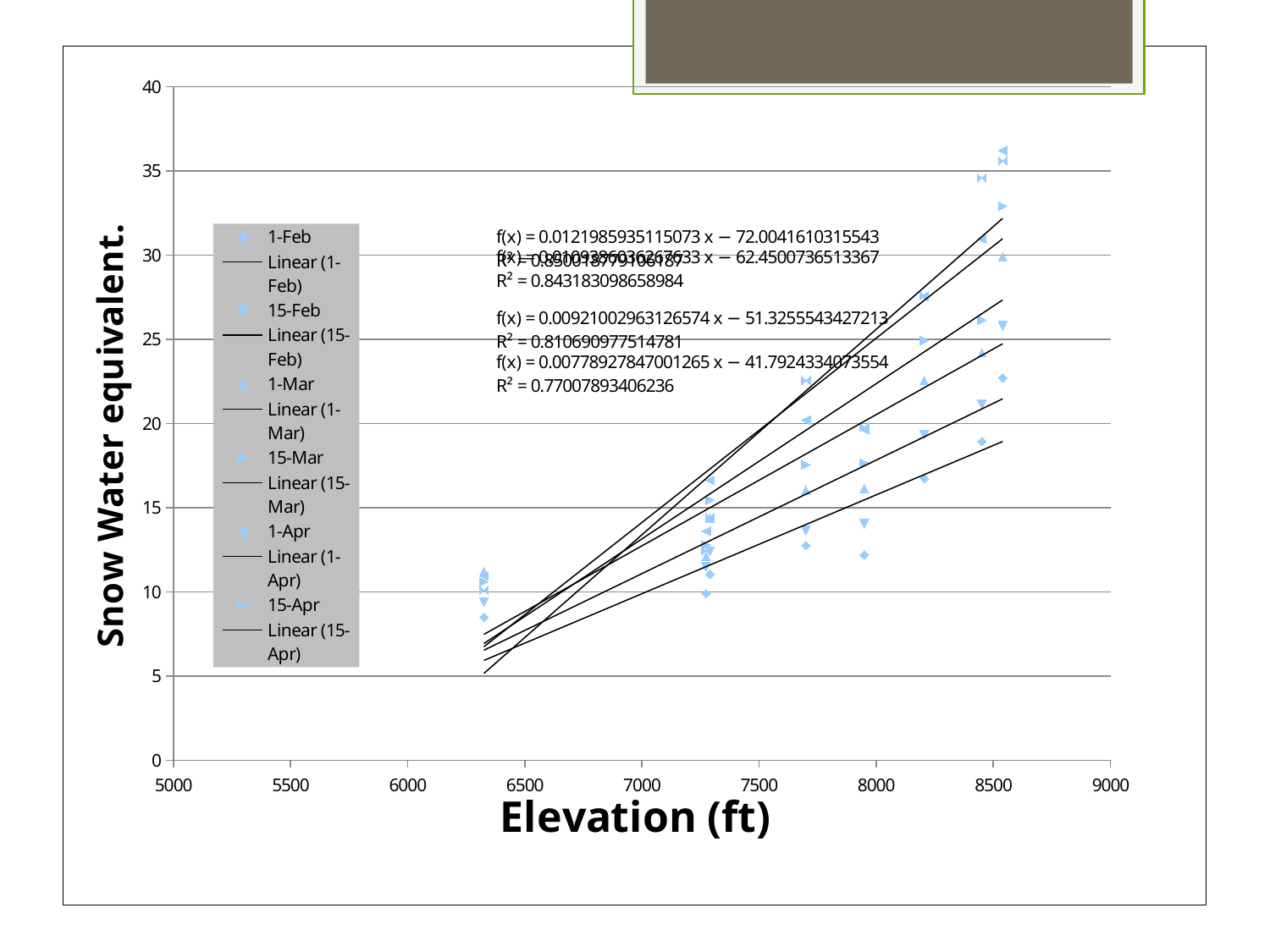
Do the snow water equivalent values generally rise or fall as elevation increases? rise What is the slope of the trendline with the equation f(x) = 0.0121985935115073 x − 72.0041610315543? 0.0121985935115073 Which printed trendline equation has the largest slope? f(x) = 0.0121985935115073 x − 72.0041610315543 What is the title of the x axis of the chart? Elevation (ft) How many tick labels are shown on the x axis of the chart? 9 How many entries does the chart's legend list? 12 What is the R² value printed for the trendline f(x) = 0.00921002963126574 x − 51.3255543427213? 0.810690977514781 Are the snow water equivalent values plotted at about 6300 ft elevation greater or less than 15? less What is the title of the y axis of the chart? Snow Water equivalent. What is the lowest R² value printed on the chart? 0.77007893406236 Is the highest snow water equivalent value plotted at about 8550 ft elevation greater or less than 35? greater What kind of chart is shown on the slide? scatter chart